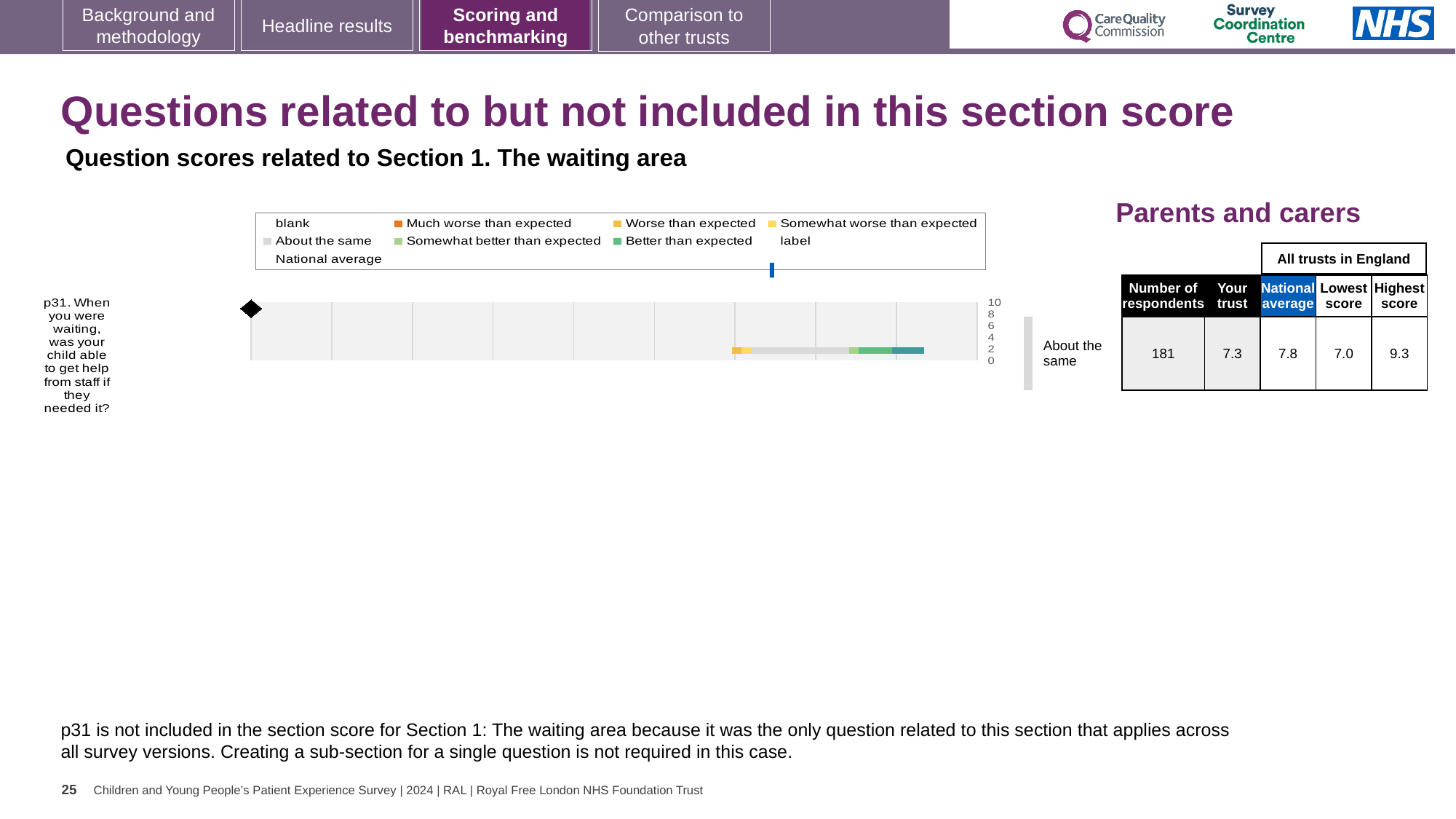
What is the difference between the national average and the 'Your trust' score for question p31? 0.5 What is the lowest score among all trusts in England for question p31? 7.0 What is the maximum value shown on the chart's score axis? 10 What is the highest score among all trusts in England for question p31? 9.3 What kind of chart is used to show the benchmarking result for question p31? bar chart Which benchmarking category is shown next to the bar for question p31? About the same Which is larger for question p31, the 'Your trust' score or the national average? National average What is the national average score for question p31? 7.8 What is the difference between the highest and lowest scores among all trusts in England for question p31? 2.3 How many survey questions are plotted on the chart? 1 What is the 'Your trust' score for question p31? 7.3 How many respondents answered question p31? 181